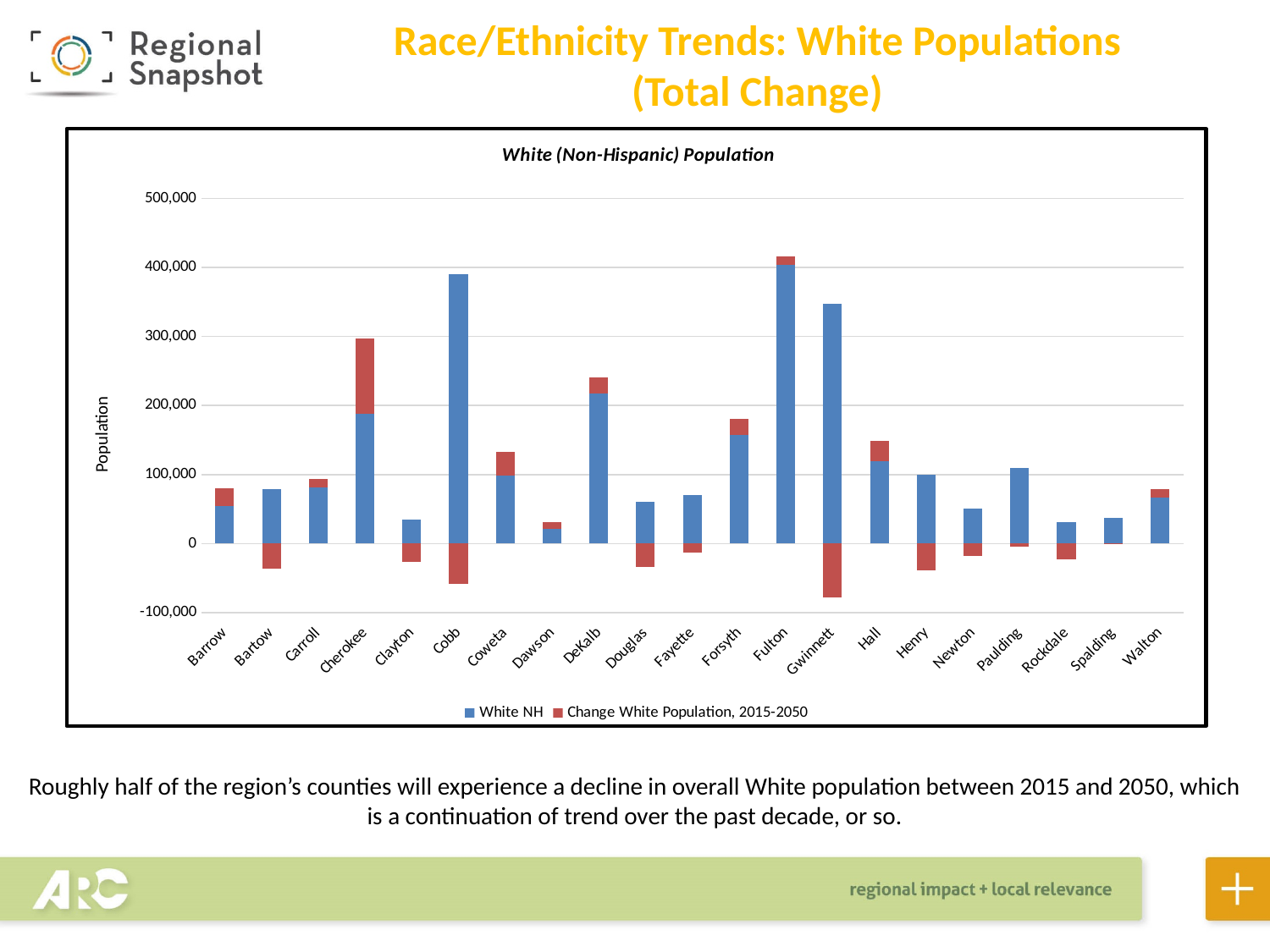
Which county has the most negative Change White Population, 2015-2050? Gwinnett Which county has the largest positive Change White Population, 2015-2050? Cherokee What kind of chart is shown on the slide? Bar chart Is the Change White Population, 2015-2050 value for Gwinnett greater or less than 0? less Is the White NH value for Clayton greater or less than 100,000? less What is the label of the y axis? Population How many counties are shown on the x axis of the chart? 21 How many series does the chart's legend list? 2 Is the White NH value for Cobb greater or less than 300,000? greater Which county has the larger White NH value, Cobb or Gwinnett? Cobb What is the title of the chart? White (Non-Hispanic) Population Which county has the larger White NH value, Cherokee or Forsyth? Cherokee